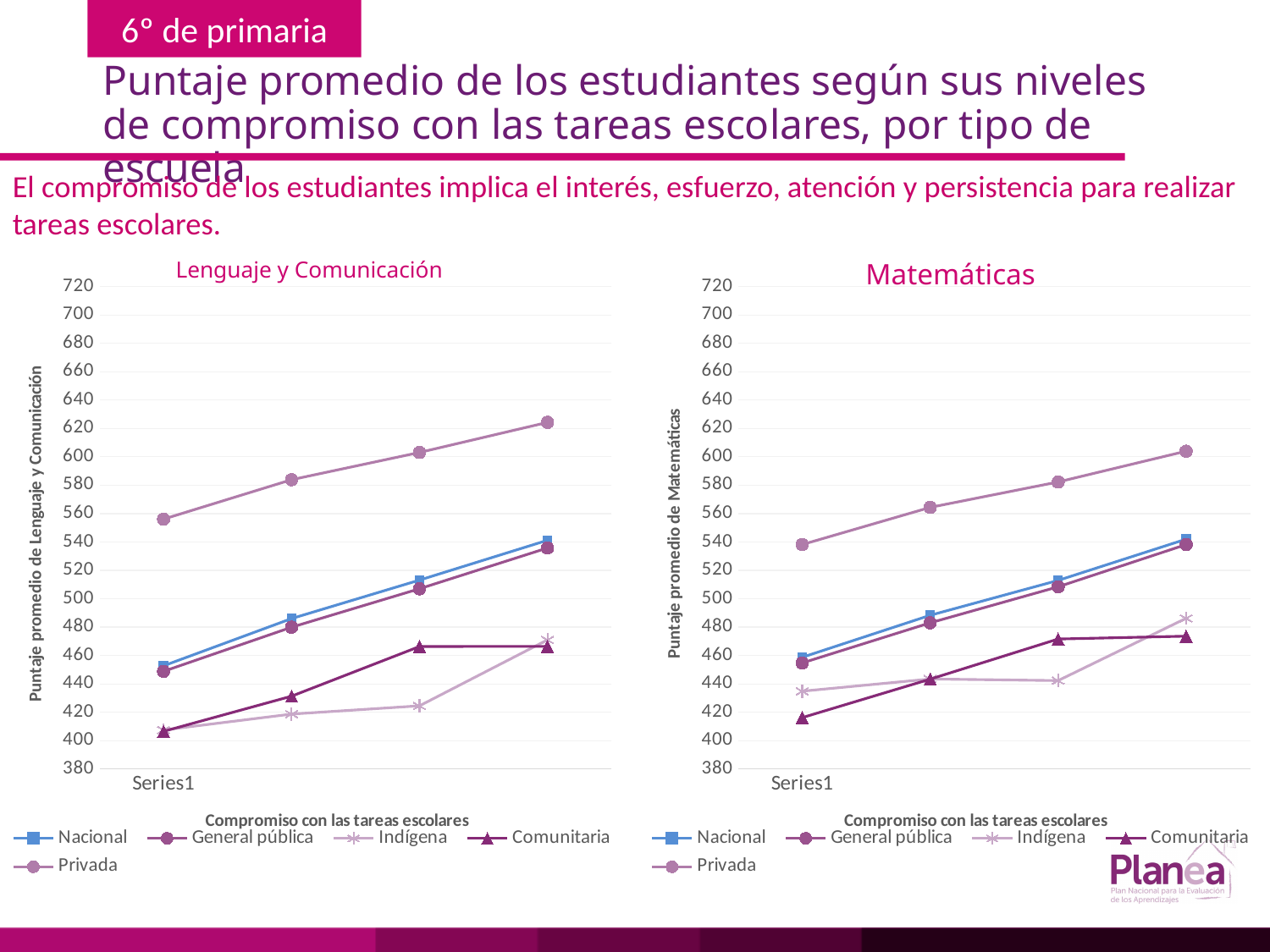
In the Matemáticas chart, is the first value for Comunitaria greater or less than 420? less In the Lenguaje y Comunicación chart, is the last value for Privada greater or less than 600? greater In the Lenguaje y Comunicación chart, which series has the highest values across all points? Privada In the Matemáticas chart, at the first point, which is larger: Indígena or Comunitaria? Indígena In the Lenguaje y Comunicación chart, at the last point, which is larger: Privada or Nacional? Privada What kind of chart is the Lenguaje y Comunicación chart? line chart What is the x-axis title of the Lenguaje y Comunicación chart? Compromiso con las tareas escolares In the Lenguaje y Comunicación chart, do the values for Nacional rise or fall along the x axis? rise How many series does the legend of the Matemáticas chart list? 5 How many points does each series have in the Matemáticas chart? 4 In the Matemáticas chart, which series has the highest values across all points? Privada In the Matemáticas chart, which series has the lowest value at the first point? Comunitaria